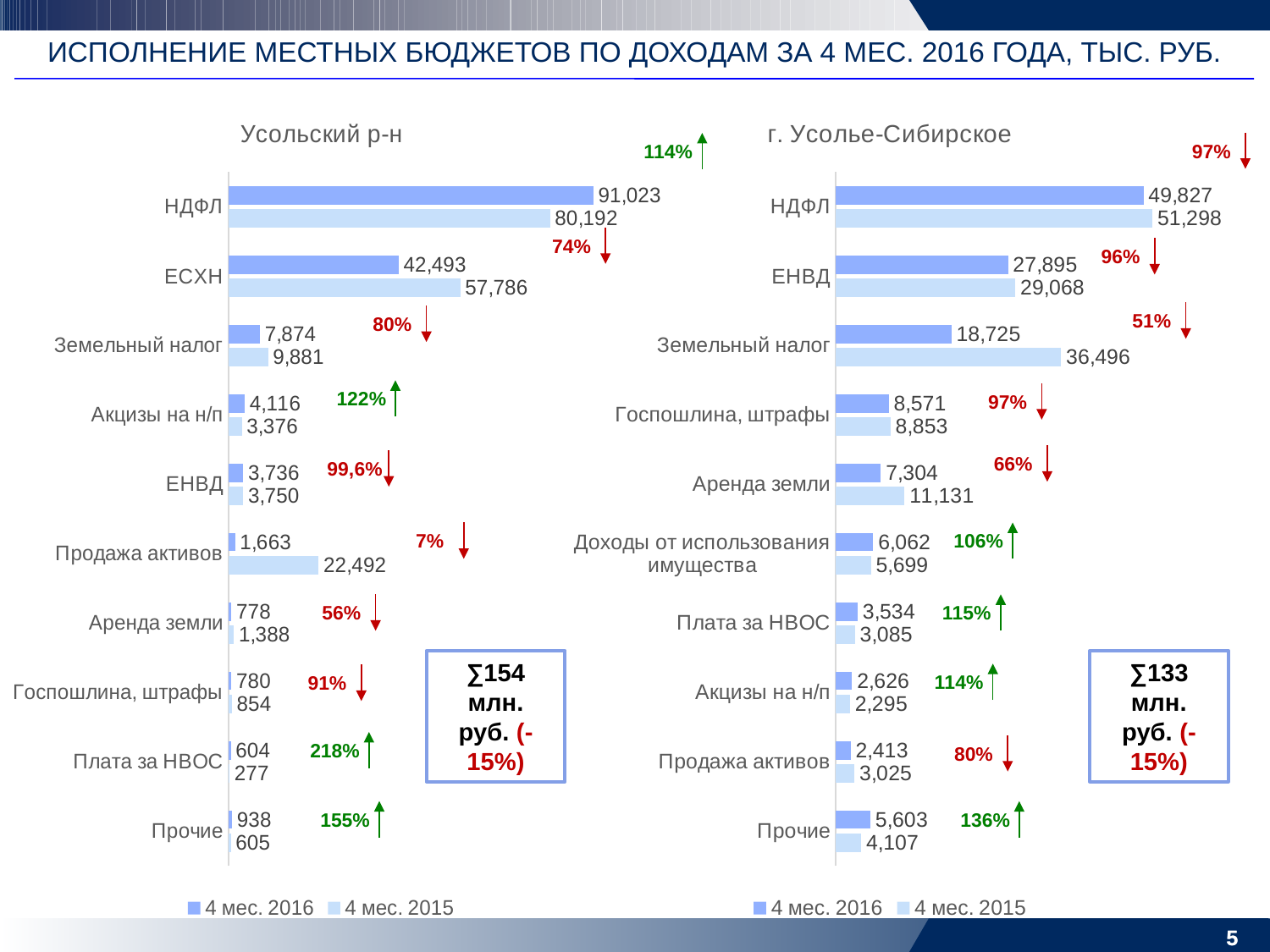
What type of chart is the 'Усольский р-н' chart? Bar chart In the 'г. Усолье-Сибирское' chart, what is the value for Земельный налог in the '4 мес. 2015' series? 36,496 In the 'Усольский р-н' chart, what is the value for Продажа активов in the '4 мес. 2015' series? 22,492 How many series does the legend of the 'Усольский р-н' chart list? 2 In the 'г. Усолье-Сибирское' chart, what is the difference between the '4 мес. 2015' and '4 мес. 2016' values for Земельный налог? 17,771 In the 'Усольский р-н' chart, which category has the highest value in the '4 мес. 2016' series? НДФЛ In the 'г. Усолье-Сибирское' chart, what is the value for Прочие in the '4 мес. 2016' series? 5,603 In the 'Усольский р-н' chart, which category has the lowest value in the '4 мес. 2015' series? Плата за НВОС How many categories are shown in the 'г. Усолье-Сибирское' chart? 10 In the 'г. Усолье-Сибирское' chart, which is larger for Аренда земли: the '4 мес. 2016' value or the '4 мес. 2015' value? 4 мес. 2015 In the 'Усольский р-н' chart, what is the value for НДФЛ in the '4 мес. 2016' series? 91,023 In the 'Усольский р-н' chart, what is the difference between the '4 мес. 2016' and '4 мес. 2015' values for НДФЛ? 10,831